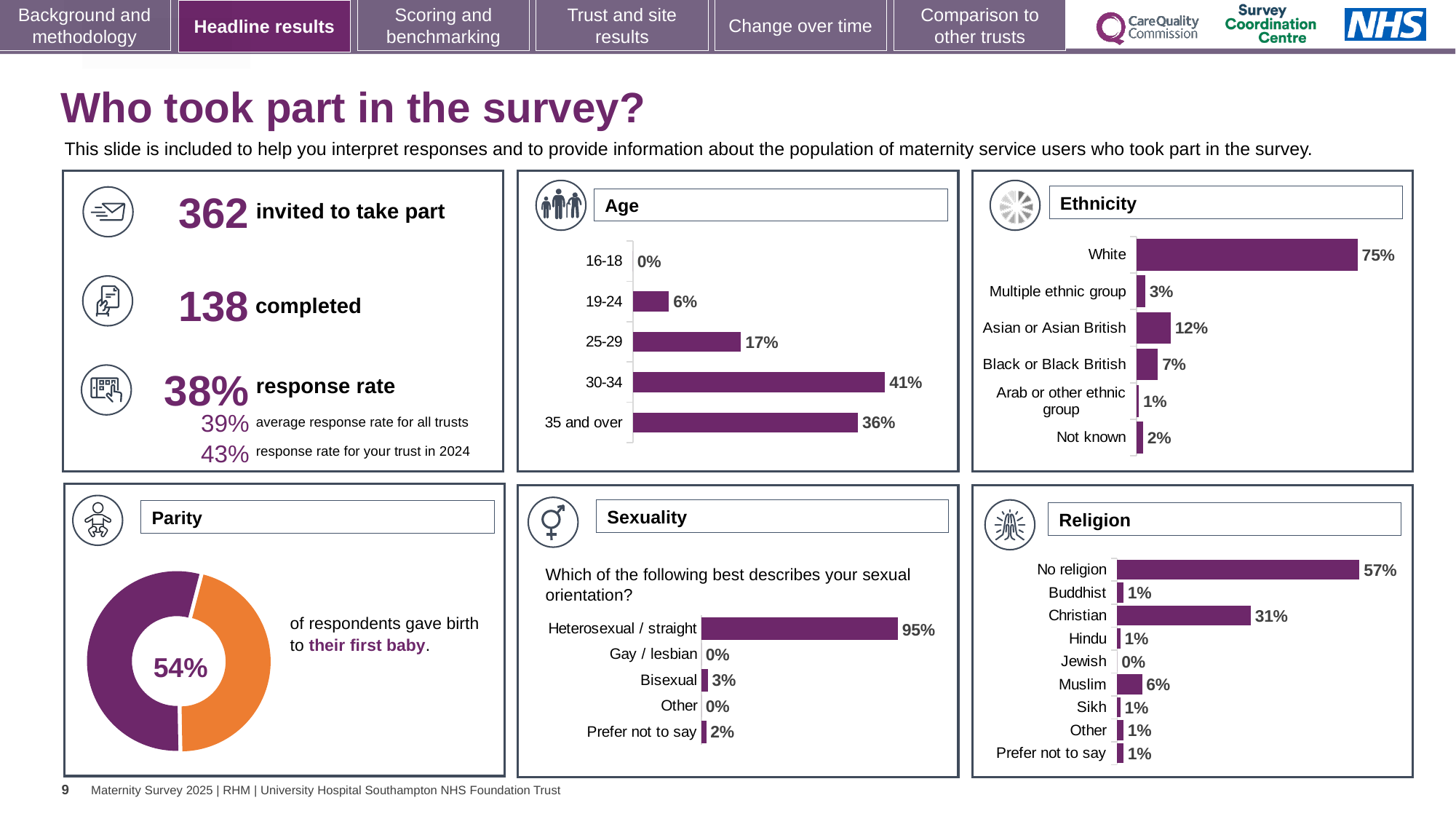
In the Ethnicity chart, which category has the lowest percentage? Arab or other ethnic group In the Ethnicity chart, which is larger: Asian or Asian British or Black or Black British? Asian or Asian British In the Sexuality chart, what percentage of respondents answered Heterosexual / straight? 95% In the Ethnicity chart, what percentage of respondents were White? 75% In the Age chart, what is the difference between the 30-34 and 35 and over percentages? 5% In the Religion chart, what percentage of respondents were Christian? 31% In the Parity chart, what percentage of respondents gave birth to their first baby? 54% What kind of chart is the Parity chart? Doughnut chart In the Age chart, which age group has the highest percentage? 30-34 In the Religion chart, what is the difference between No religion and Christian? 26% How many categories are shown in the Ethnicity chart? 6 In the Age chart, what percentage of respondents were aged 30-34? 41%